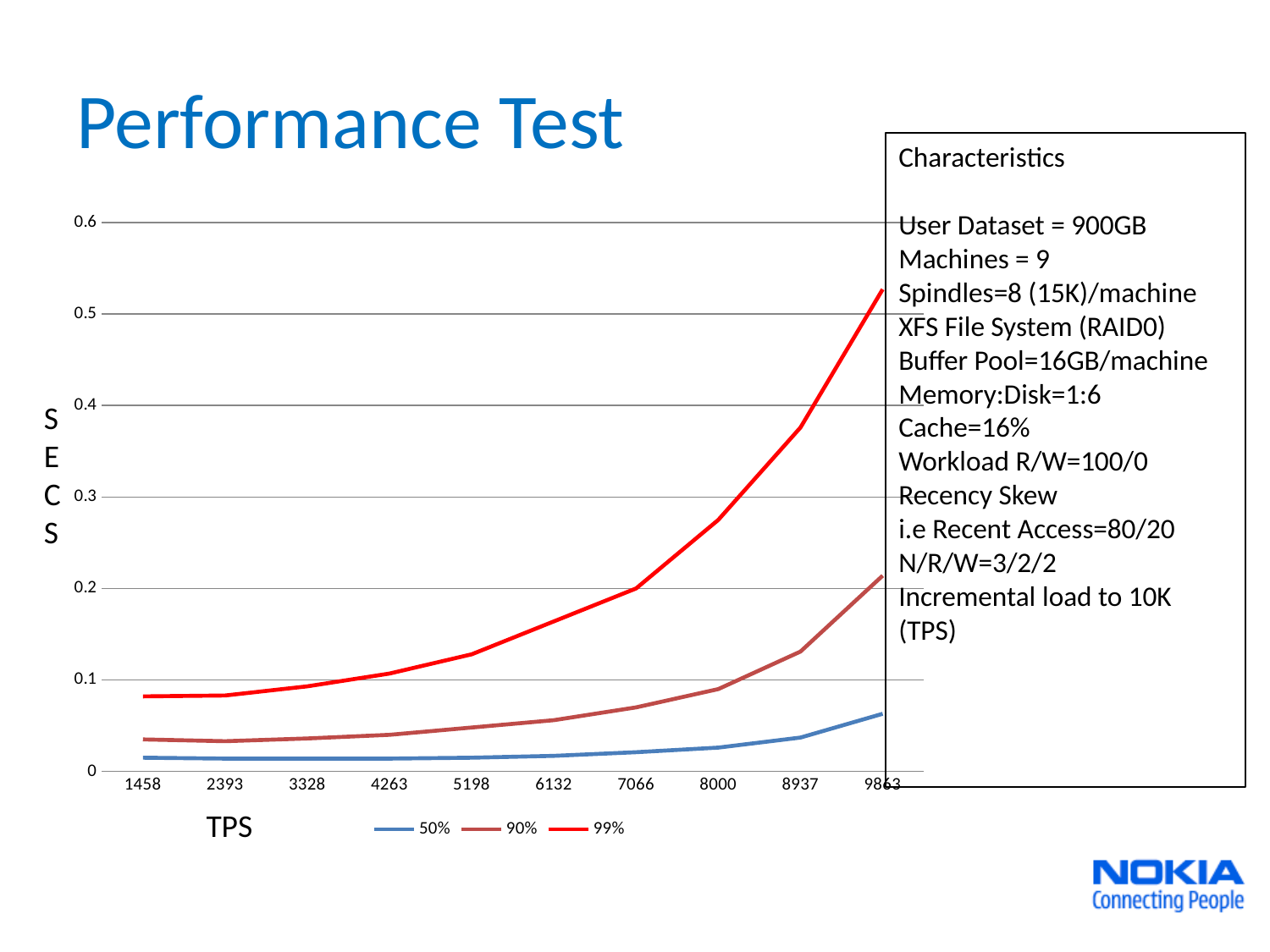
Is the value of the 99% series at 1458 TPS greater or less than 0.1? less Is the value of the 99% series at 8000 TPS greater or less than 0.2? greater At 8937 TPS, which series has the larger value, 99% or 50%? 99% Is the value of the 99% series at 9863 TPS greater or less than 0.4? greater How many series does the legend of the chart list? 3 Does the 99% series rise or fall as TPS increases along the x axis? rise What kind of chart is shown on the slide? line chart How many TPS values are shown along the x axis of the chart? 10 What label is shown on the x axis of the chart? TPS Which series has the lowest value at 1458 TPS? 50%